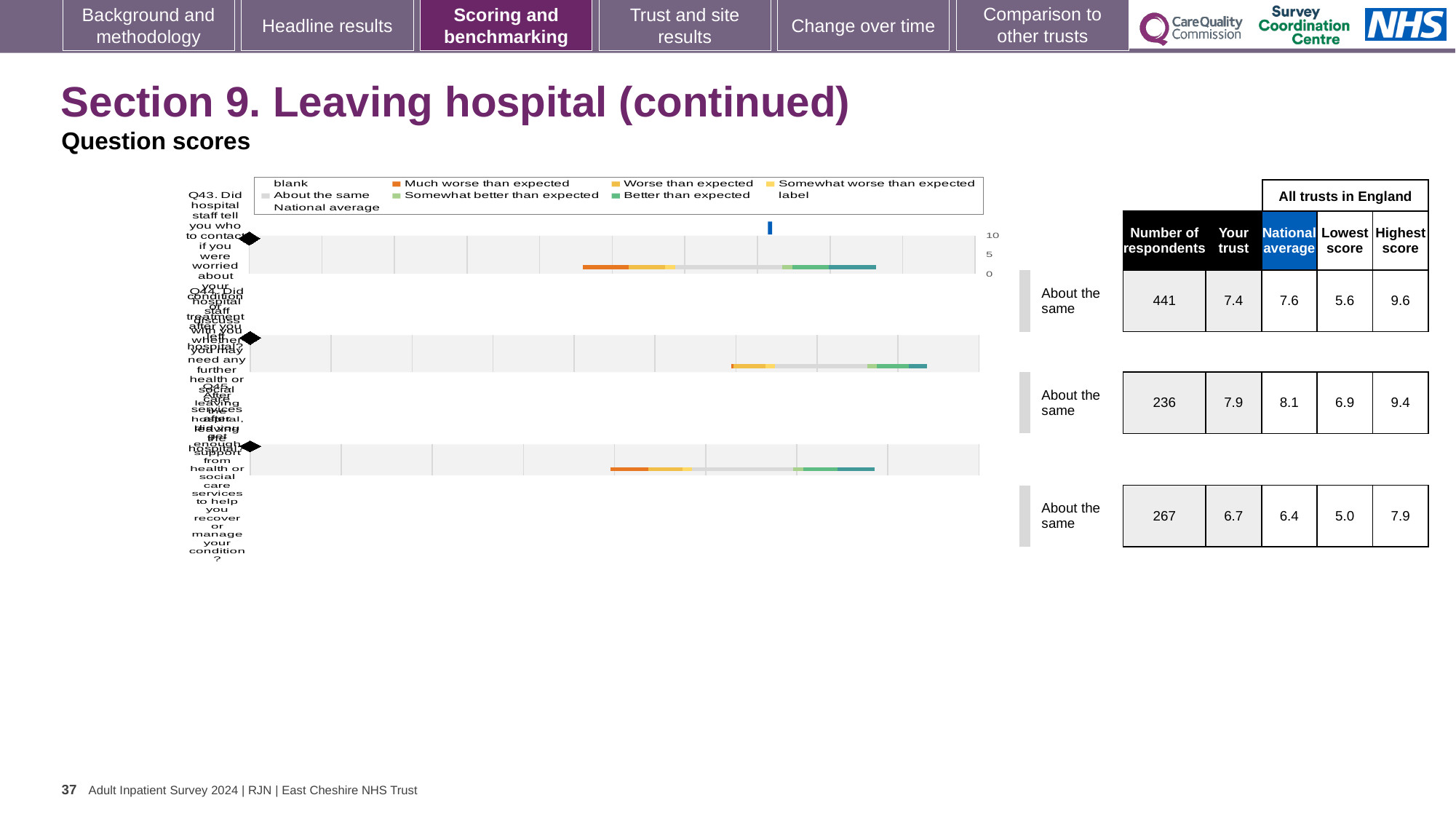
What type of chart is used to show the question scores on this slide? bar chart In the middle chart (Q44), what is the national average score? 8.1 In the bottom chart (Q45), what is the difference between the 'Your trust' score and the national average? 0.3 In the top chart (Q43), what is the 'Your trust' score? 7.4 In the bottom chart (Q45), what is the lowest score among all trusts in England? 5.0 Which of the three question charts has the fewest respondents? Q44 (middle chart), 236 In the top chart (Q43), is the 'Your trust' score higher or lower than the national average? lower In the bottom chart (Q45), what is the highest score among all trusts in England? 7.9 In the top chart (Q43), how many respondents are shown? 441 How many question charts are shown on the slide? 3 What benchmark category is shown next to each of the three charts? About the same Which of the three question charts has the highest 'Your trust' score? Q44 (middle chart), 7.9